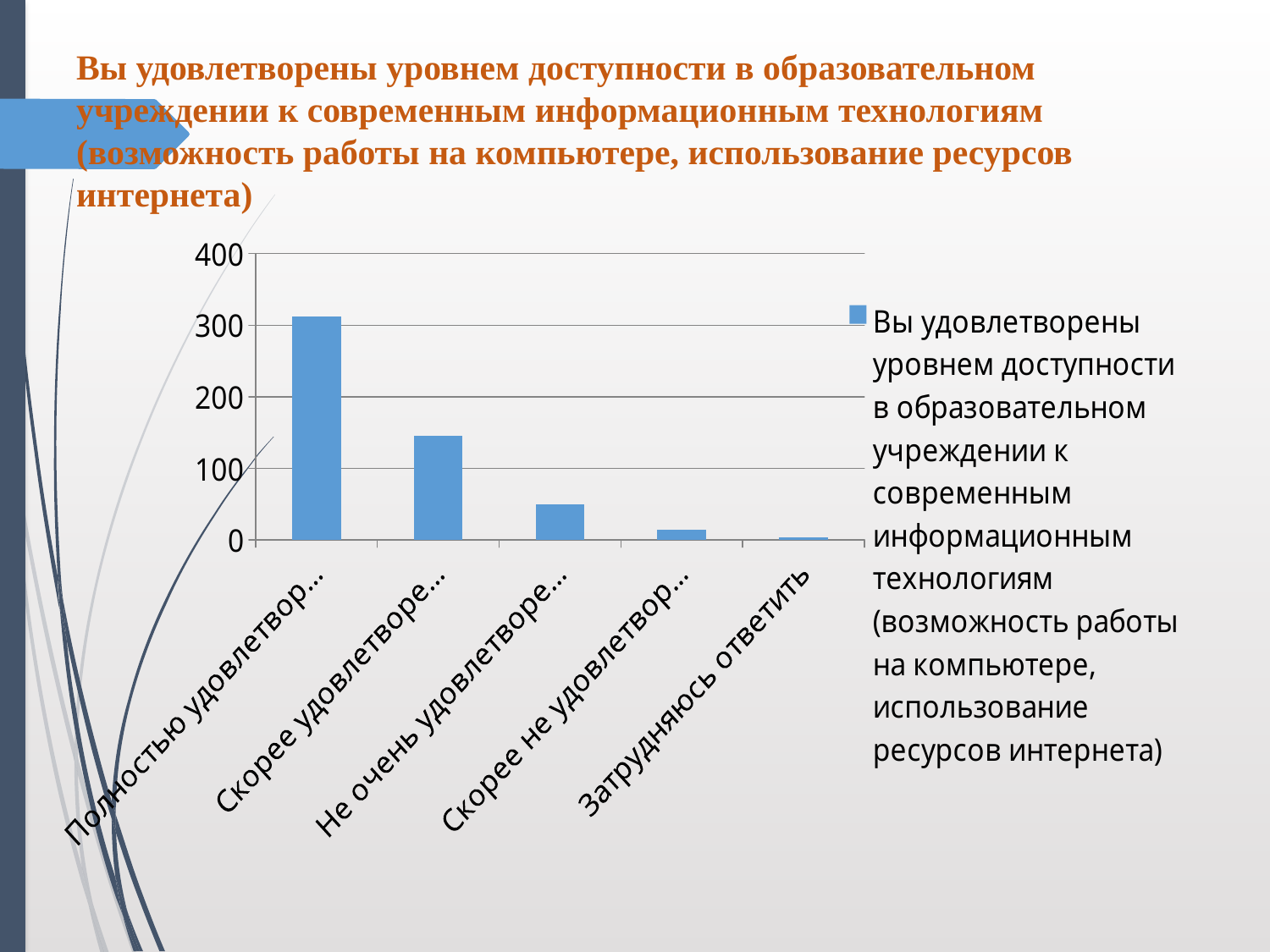
Is the value for "Полностью удовлетвор..." greater or less than 300? greater Which category has the lowest bar? Затрудняюсь ответить Which is larger: the value for "Скорее удовлетворе..." or the value for "Не очень удовлетворе..."? Скорее удовлетворе... Which category has the highest bar? Полностью удовлетвор... Is the value for "Не очень удовлетворе..." greater or less than 100? less Is the value for "Скорее удовлетворе..." greater or less than 200? less What colour are the bars in the chart? blue What is the highest value shown on the vertical axis? 400 What kind of chart is shown on the slide? bar chart How many series does the legend list? 1 How many categories (bars) are plotted in the chart? 5 Do the bar values rise or fall from left to right along the x axis? fall